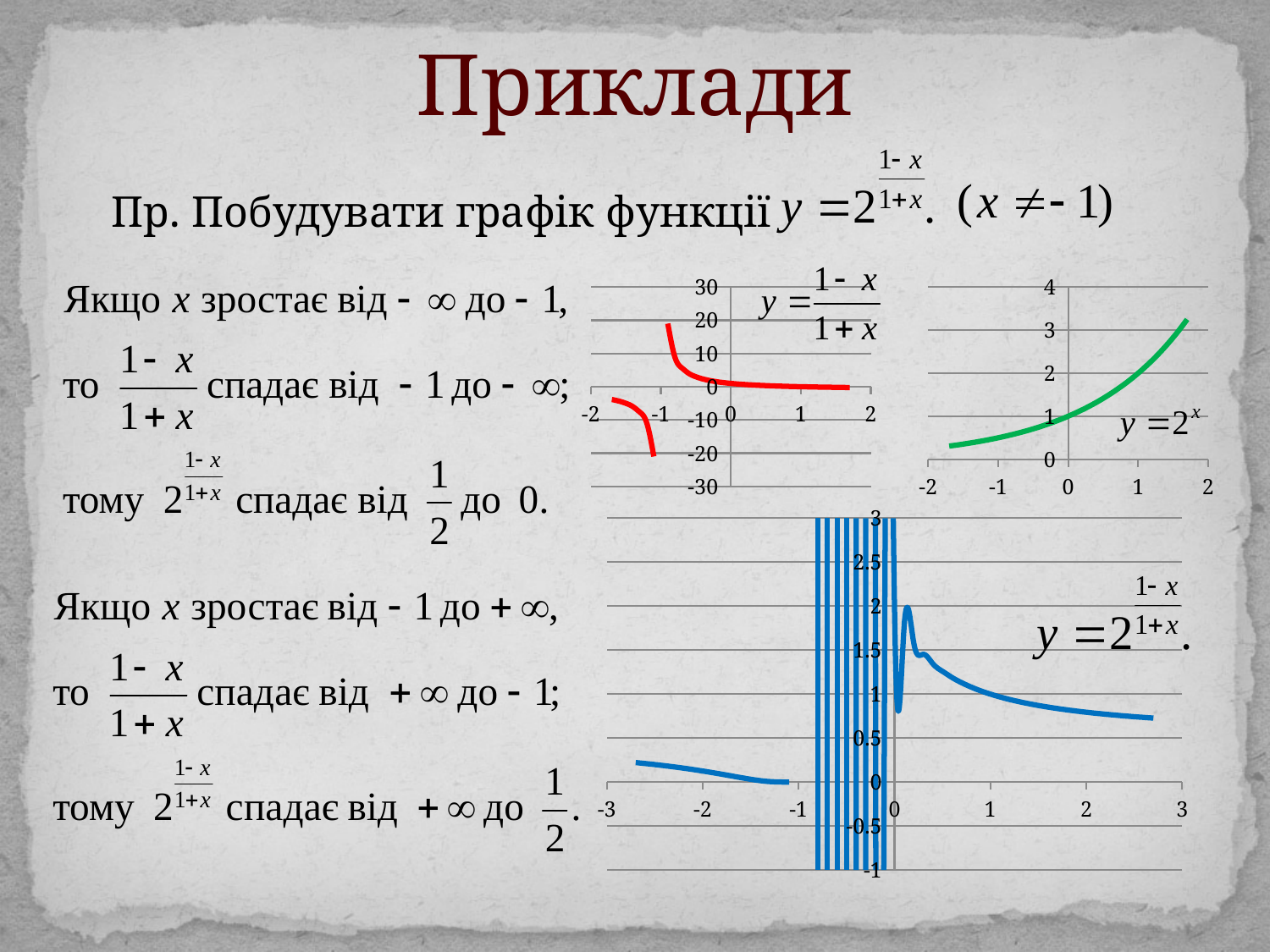
In the top-left chart (y = (1-x)/(1+x)), is the value at x = 1 greater or less than 10? less In the top-right chart (y = 2^x), does the green curve rise or fall as x increases from -2 to 2? rises What colour is the curve in the top-left chart (y = (1-x)/(1+x))? red In the bottom chart (y = 2^((1-x)/(1+x))), is the value at x = -2 greater or less than 0.5? less What is the lowest x-axis tick shown on the bottom chart (y = 2^((1-x)/(1+x)))? -3 In the top-right chart (y = 2^x), is the value at x = 1 greater or less than 1? greater How many charts are shown on the slide? 3 In the bottom chart (y = 2^((1-x)/(1+x))), does the blue curve rise or fall as x increases from 1 to 3? falls What is the highest y-axis tick shown on the top-right chart (y = 2^x)? 4 What kind of chart is the top-right chart labelled y = 2^x? line chart